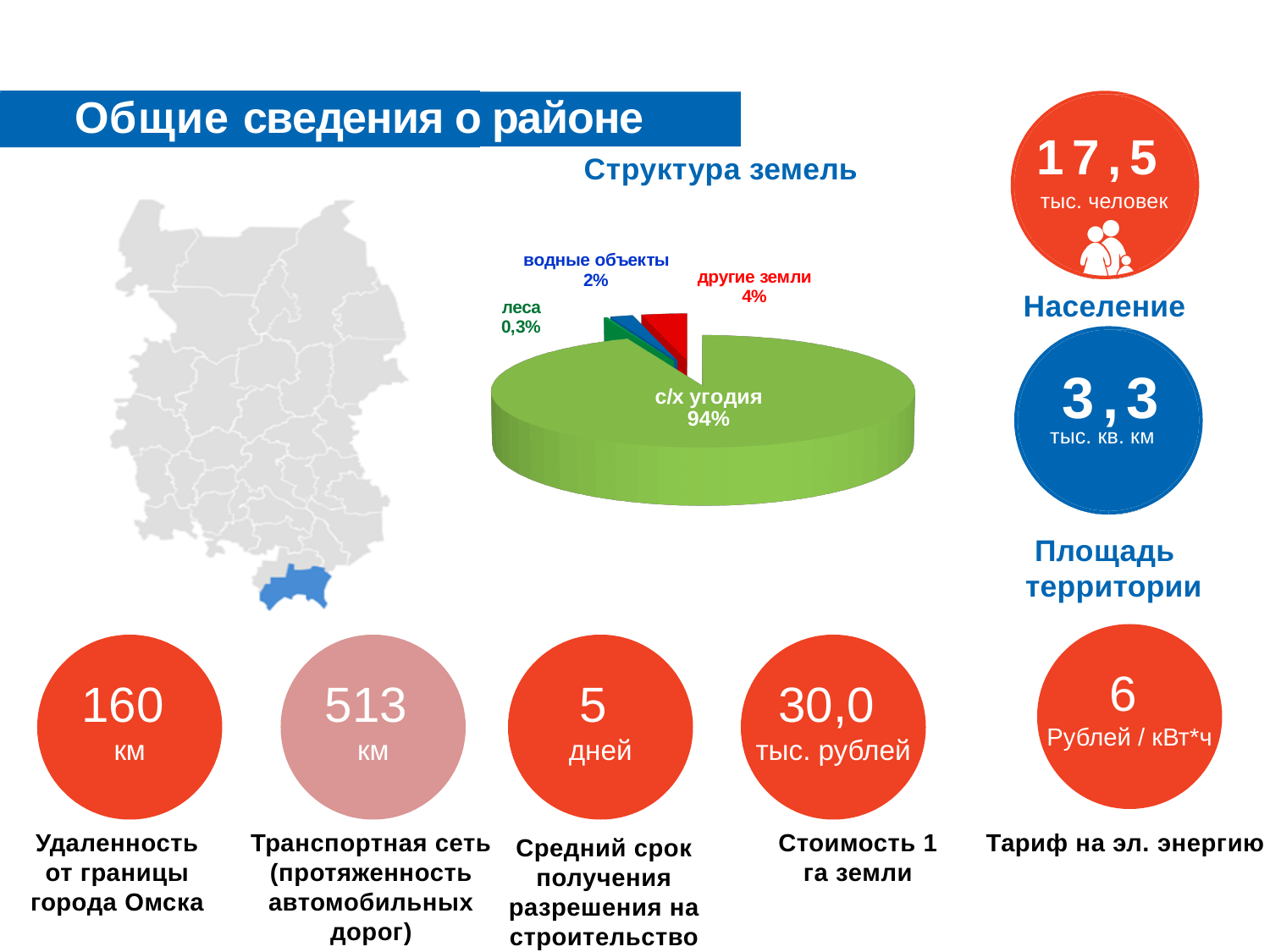
Which category has the largest slice in the pie chart? с/х угодия What share of the pie chart is "с/х угодия"? 94% What share of the pie chart is "водные объекты"? 2% Which is larger in the pie chart: "другие земли" or "водные объекты"? другие земли What is the difference in percentage points between "с/х угодия" and "другие земли" in the pie chart? 90 What is the title of the pie chart? Структура земель What share of the pie chart is "другие земли"? 4% What share of the pie chart is "леса"? 0,3% How many slices does the pie chart have? 4 What colour is the "с/х угодия" slice in the pie chart? green What type of chart is shown under the title "Структура земель"? pie chart Which category has the smallest slice in the pie chart? леса